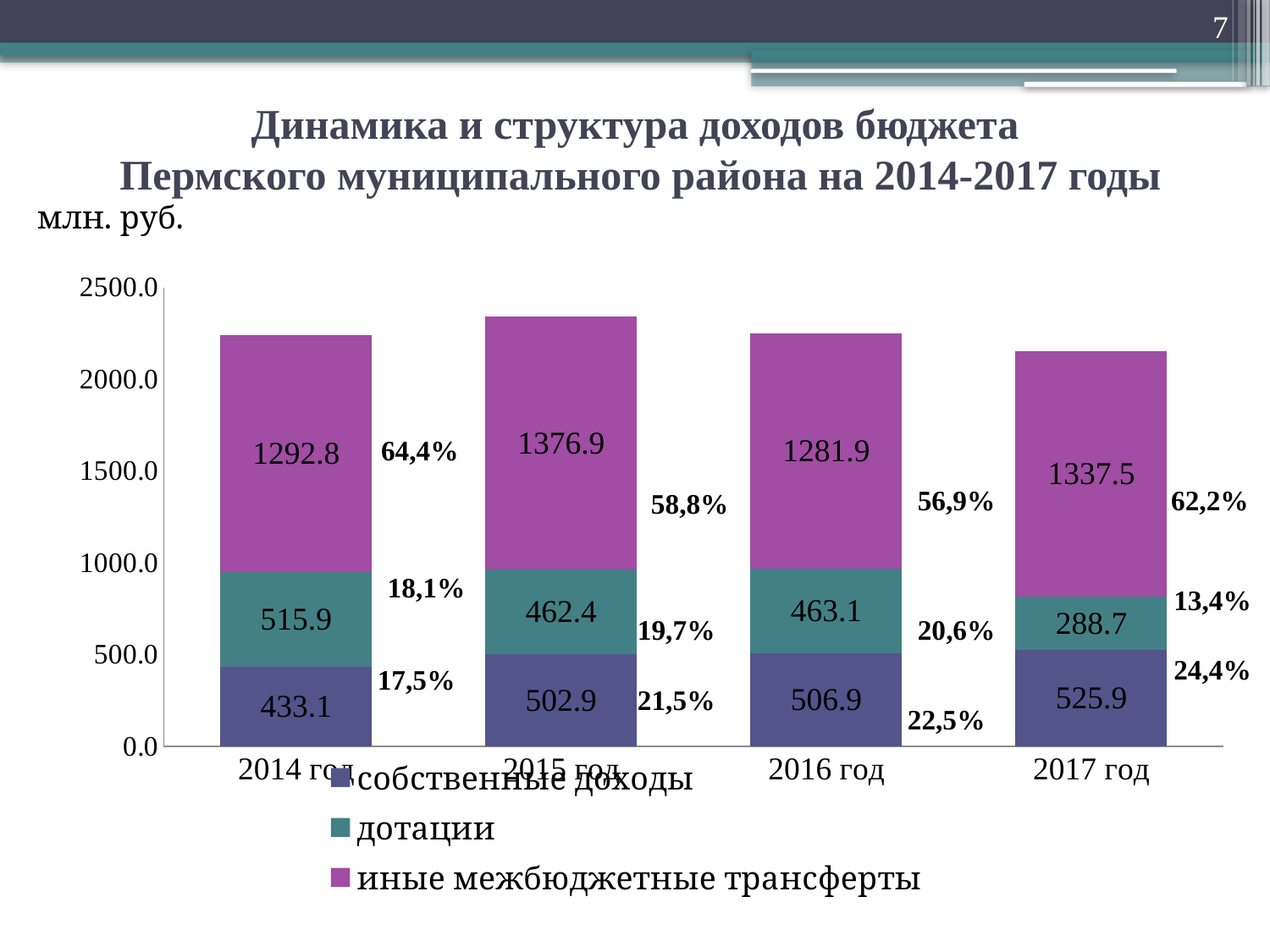
Do the values of собственные доходы rise or fall from 2014 год to 2017 год? rise What is the value of иные межбюджетные трансферты for 2015 год? 1376.9 What is the value of собственные доходы for 2014 год? 433.1 What is the value of дотации for 2017 год? 288.7 Which is larger: дотации in 2015 год or дотации in 2016 год? дотации in 2016 год How many series does the legend list? 3 What type of chart is shown on the slide? stacked bar chart In which year is the value of иные межбюджетные трансферты the highest? 2015 год What is the total of the stacked bar for 2017 год? 2152.1 How many years (categories) are shown on the x axis? 4 What is the difference between собственные доходы in 2017 год and in 2014 год? 92.8 In which year is the value of дотации the lowest? 2017 год